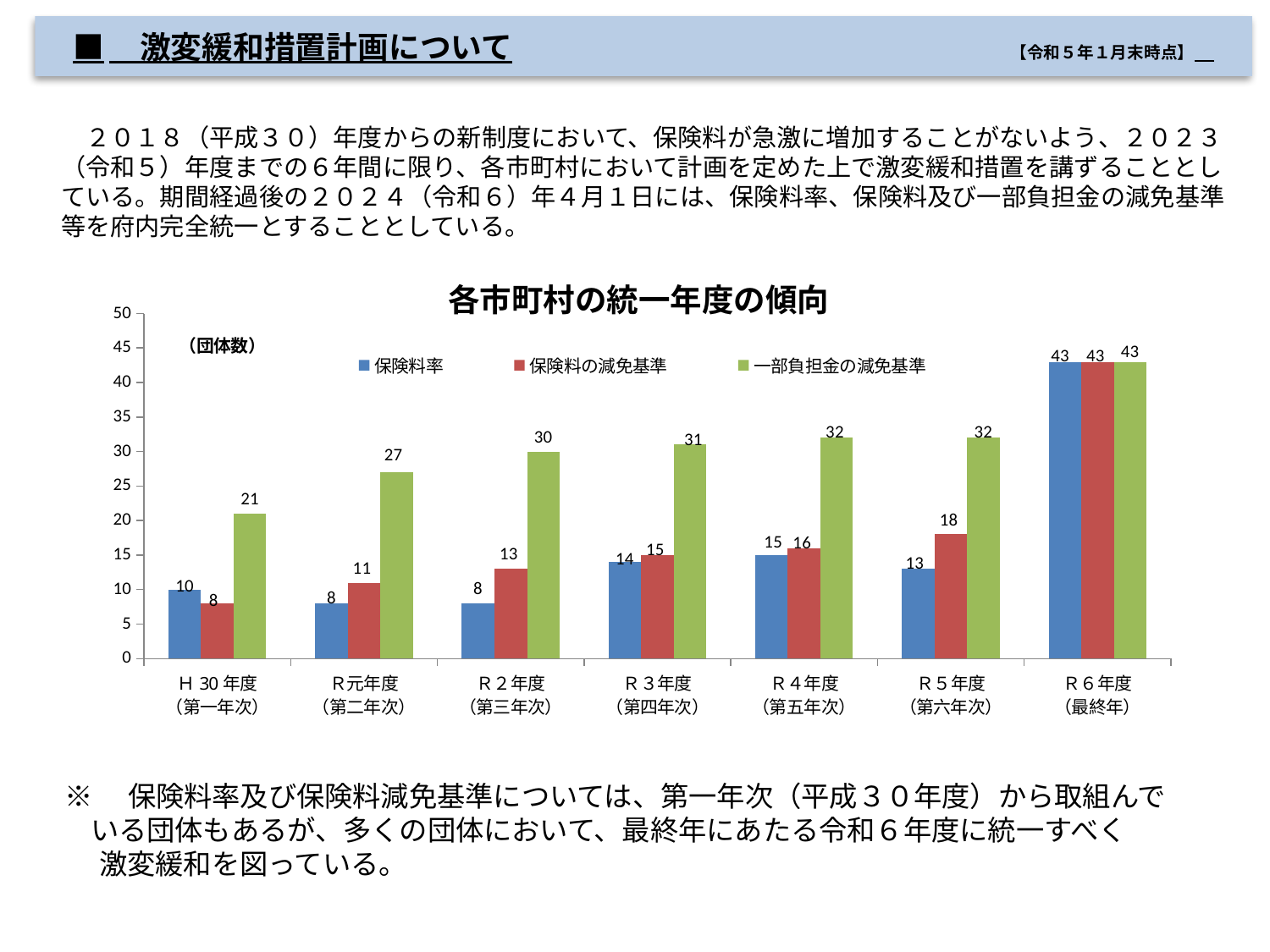
グラフ「各市町村の統一年度の傾向」で、R３年度（第四年次）の一部負担金の減免基準の値は30より大きいですか、小さいですか？ 大きい グラフ「各市町村の統一年度の傾向」の凡例には、いくつの系列がありますか？ 3 グラフ「各市町村の統一年度の傾向」で、一部負担金の減免基準の団体数が最も少ない年度はどれですか？ H30年度（第一年次） グラフ「各市町村の統一年度の傾向」で、保険料率の団体数が最も多い年度はどれですか？ R６年度（最終年） グラフ「各市町村の統一年度の傾向」で、H30年度（第一年次）の保険料率の団体数はいくつですか？ 10 グラフ「各市町村の統一年度の傾向」で、R元年度（第二年次）の一部負担金の減免基準と保険料率の団体数の差はいくつですか？ 19 グラフ「各市町村の統一年度の傾向」で、一部負担金の減免基準の団体数はH30年度からR６年度にかけて増加していますか、減少していますか？ 増加 グラフ「各市町村の統一年度の傾向」には、年度のカテゴリがいくつありますか？ 7 グラフ「各市町村の統一年度の傾向」で、R４年度（第五年次）の保険料率と保険料の減免基準では、どちらの団体数が多いですか？ 保険料の減免基準 グラフ「各市町村の統一年度の傾向」はどの種類のグラフですか？ 棒グラフ グラフ「各市町村の統一年度の傾向」で、R２年度（第三年次）の一部負担金の減免基準の団体数はいくつですか？ 30 グラフ「各市町村の統一年度の傾向」で、R５年度（第六年次）の保険料の減免基準の団体数はいくつですか？ 18